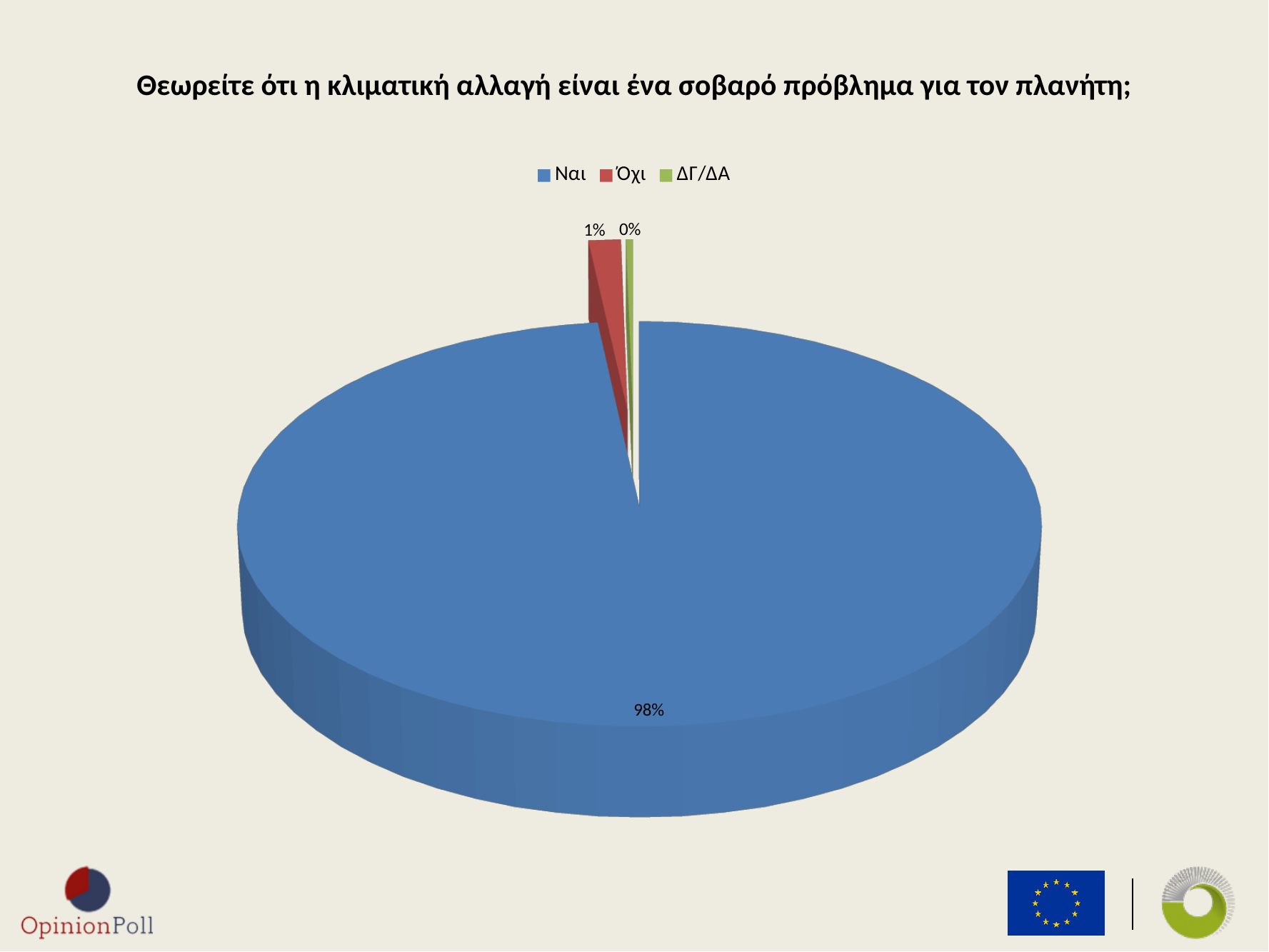
What is the value for Όχι? 1% What is the title of the chart? Θεωρείτε ότι η κλιματική αλλαγή είναι ένα σοβαρό πρόβλημα για τον πλανήτη; Which is larger, the value for Όχι or the value for ΔΓ/ΔΑ? Όχι What colour is the slice for Ναι? blue What is the difference between the values for Ναι and Όχι? 97% What is the value for Ναι? 98% Which category has the largest share of the pie? Ναι What kind of chart is shown on the slide? pie chart Which category has the smallest share of the pie? ΔΓ/ΔΑ How many entries does the legend list? 3 How many categories does the pie chart show? 3 What is the value for ΔΓ/ΔΑ? 0%